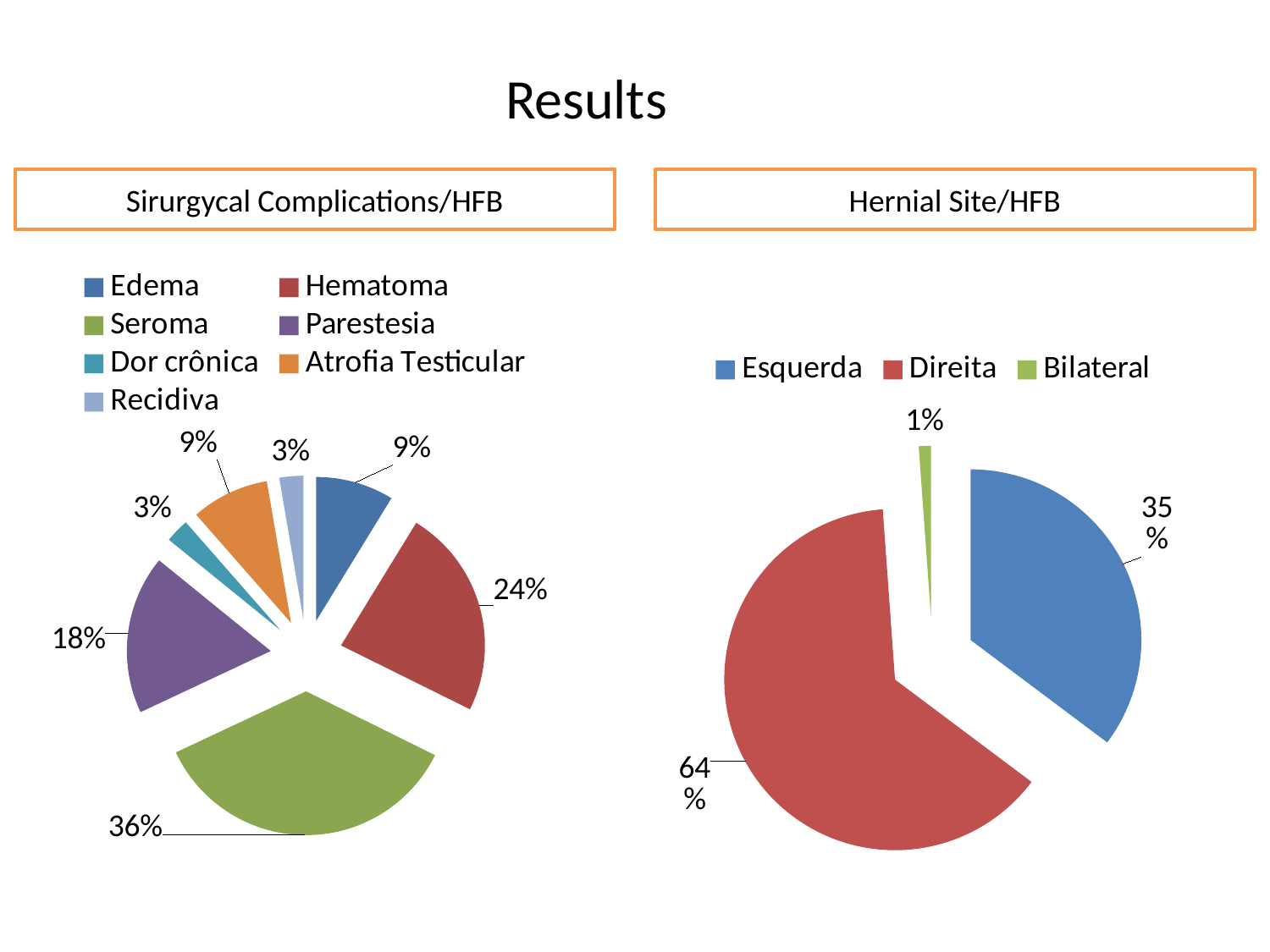
In the Sirurgycal Complications/HFB chart, what share does Seroma have? 36% In the Hernial Site/HFB chart, which category has the smallest share? Bilateral In the Sirurgycal Complications/HFB chart, which is larger, Parestesia or Edema? Parestesia In the Hernial Site/HFB chart, what is the difference between the Direita and Esquerda shares? 29% In the Sirurgycal Complications/HFB chart, what is the difference between the Seroma and Hematoma shares? 12% In the Sirurgycal Complications/HFB chart, which complication has the largest share? Seroma In the Sirurgycal Complications/HFB chart, what share does Parestesia have? 18% In the Sirurgycal Complications/HFB chart, how many categories does the legend list? 7 In the Hernial Site/HFB chart, what share does Direita have? 64% What kind of chart is the Hernial Site/HFB chart? Pie chart In the Sirurgycal Complications/HFB chart, what share does Hematoma have? 24% In the Hernial Site/HFB chart, what share does Esquerda have? 35%